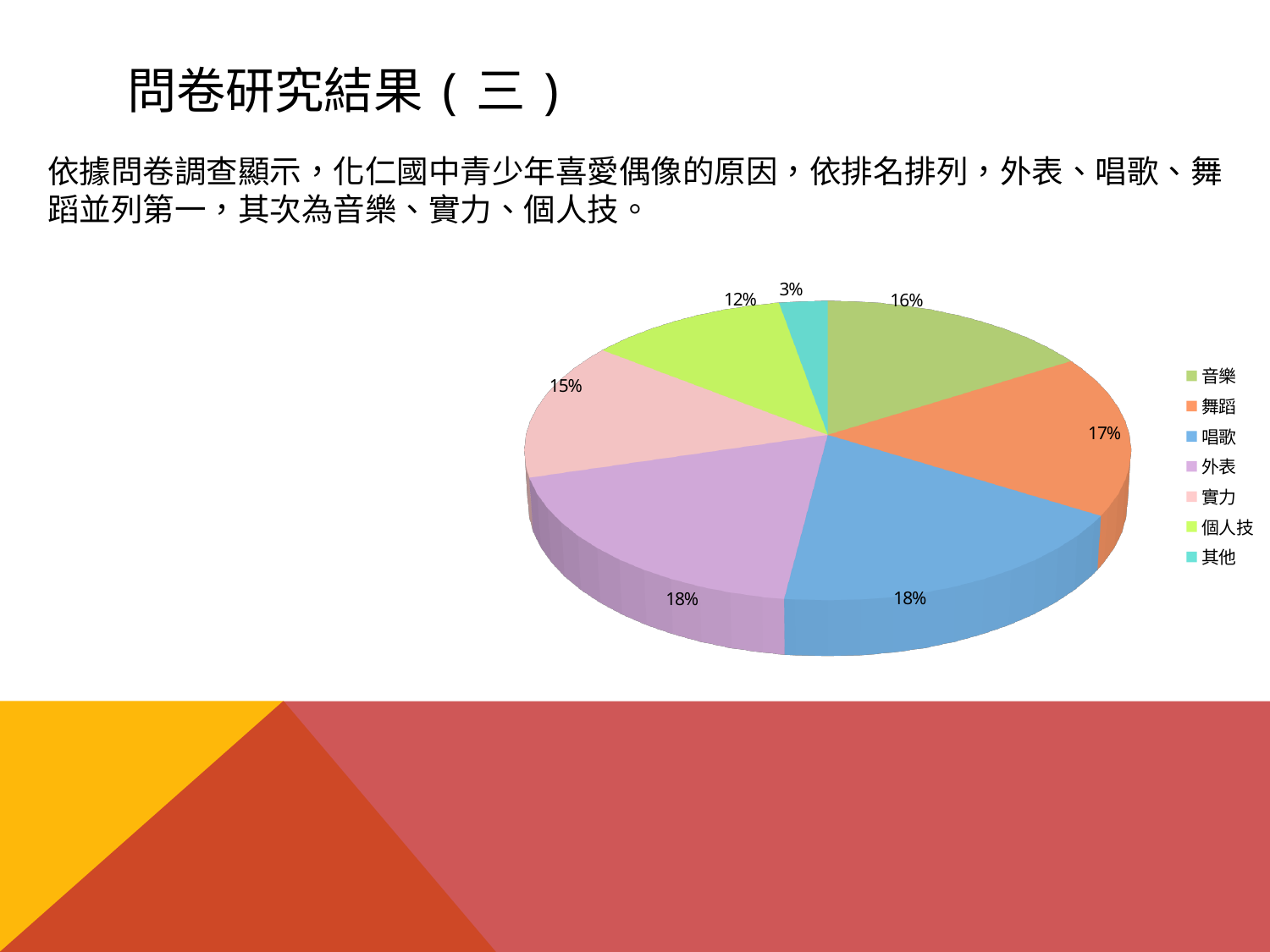
Which colour represents 唱歌 in the legend? blue What percentage of the pie does 音樂 account for? 16% What is the difference between the values for 唱歌 and 其他? 15% What kind of chart is shown on the slide? pie chart Which category has the smallest slice of the pie? 其他 What is the value shown for 實力? 15% What is the value shown for 舞蹈? 17% What is the value shown for 個人技? 12% What is the value shown for 其他? 3% Which is larger, the slice for 舞蹈 or the slice for 實力? 舞蹈 What is the difference between the values for 音樂 and 個人技? 4% How many categories does the legend list? 7